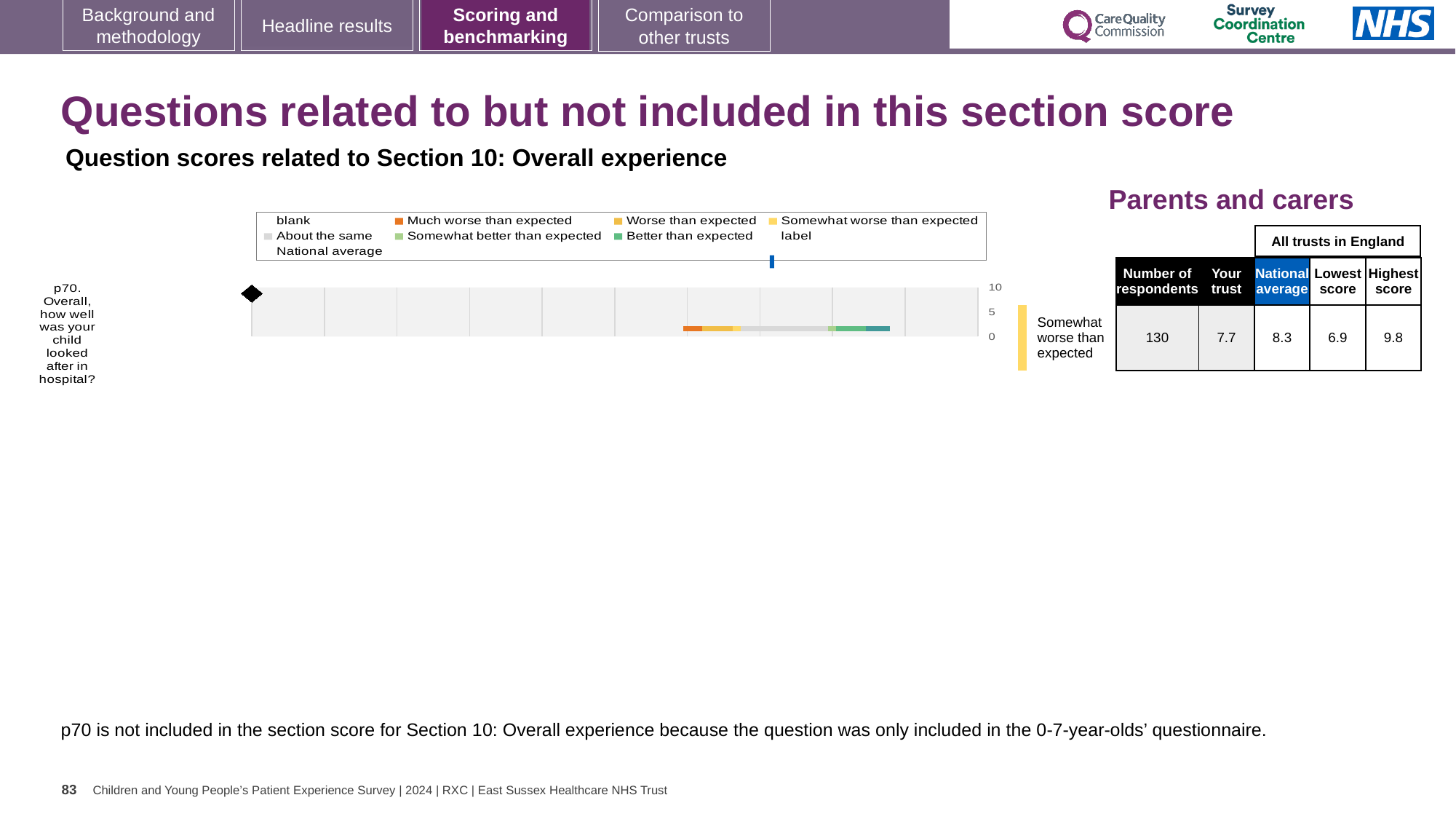
What is the lowest score among all trusts in England for p70? 6.9 Which is larger for p70: the trust's score or the national average? National average What is the maximum value shown on the chart's score axis? 10 What is the 'Your trust' score for p70 (Overall, how well was your child looked after in hospital?)? 7.7 What is the national average score for p70? 8.3 What is the highest score among all trusts in England for p70? 9.8 How much lower is the trust's p70 score than the national average? 0.6 How many respondents answered p70? 130 What is the difference between the highest and lowest trust scores for p70? 2.9 Which benchmark category is the trust's p70 score placed in? Somewhat worse than expected What kind of chart is used to show the p70 question score? bar chart How many questions are plotted in the chart? 1